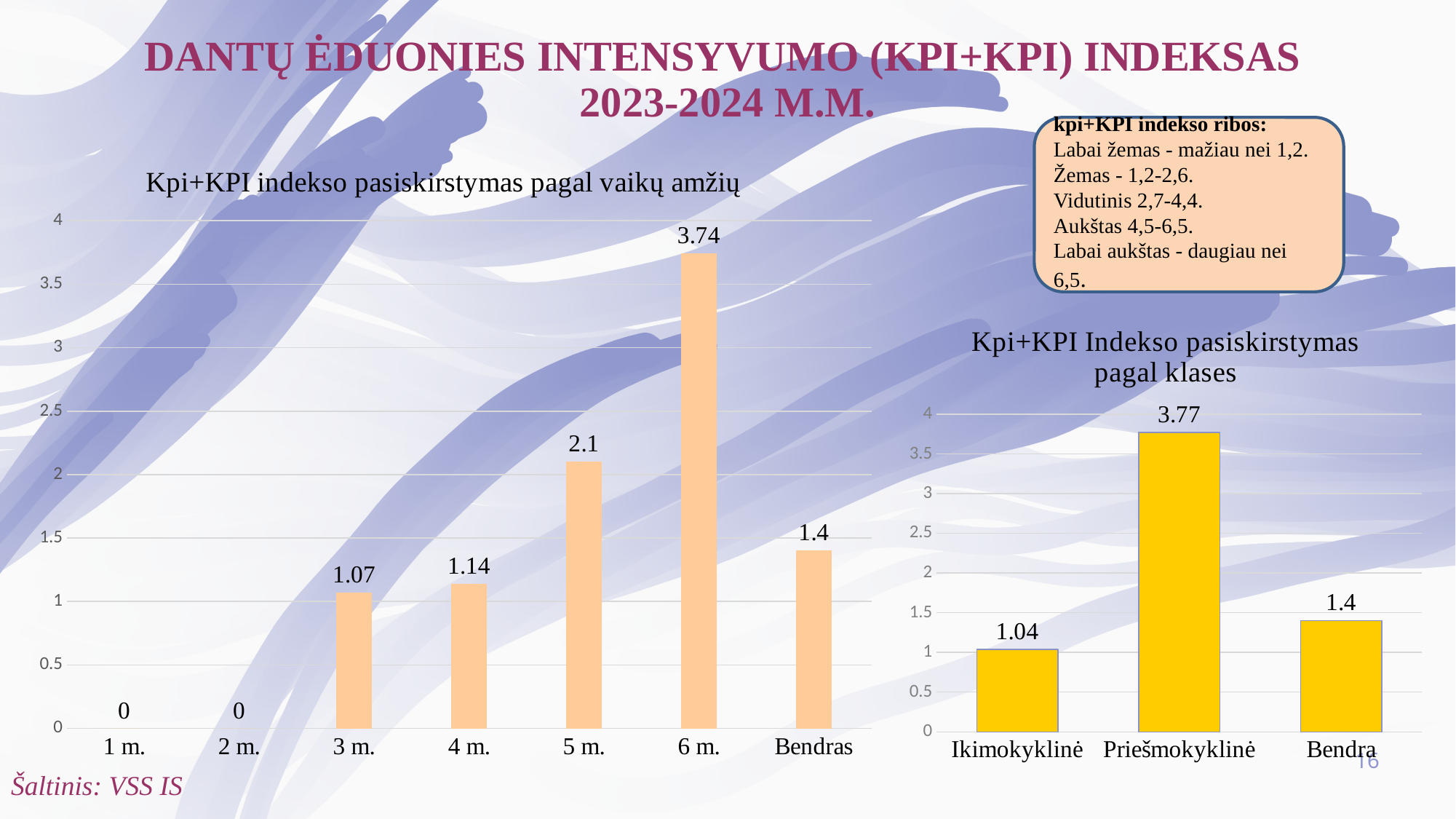
In the chart 'Kpi+KPI indekso pasiskirstymas pagal vaikų amžių', what is the difference between the values for 5 m. and 4 m.? 0.96 In the chart 'Kpi+KPI Indekso pasiskirstymas pagal klases', which category has the lowest value? Ikimokyklinė In the chart 'Kpi+KPI indekso pasiskirstymas pagal vaikų amžių', what colour are the bars? light orange In the chart 'Kpi+KPI indekso pasiskirstymas pagal vaikų amžių', what is the value for 3 m.? 1.07 What kind of chart is 'Kpi+KPI Indekso pasiskirstymas pagal klases'? bar chart In the chart 'Kpi+KPI Indekso pasiskirstymas pagal klases', what is the value for Priešmokyklinė? 3.77 In the chart 'Kpi+KPI Indekso pasiskirstymas pagal klases', what is the difference between the values for Priešmokyklinė and Ikimokyklinė? 2.73 In the chart 'Kpi+KPI indekso pasiskirstymas pagal vaikų amžių', what is the value for Bendras? 1.4 In the chart 'Kpi+KPI Indekso pasiskirstymas pagal klases', is the value for Bendra larger or smaller than the value for Ikimokyklinė? larger In the chart 'Kpi+KPI indekso pasiskirstymas pagal vaikų amžių', what is the value for 6 m.? 3.74 In the chart 'Kpi+KPI indekso pasiskirstymas pagal vaikų amžių', how many categories are shown on the x axis? 7 In the chart 'Kpi+KPI indekso pasiskirstymas pagal vaikų amžių', which category has the highest value? 6 m.